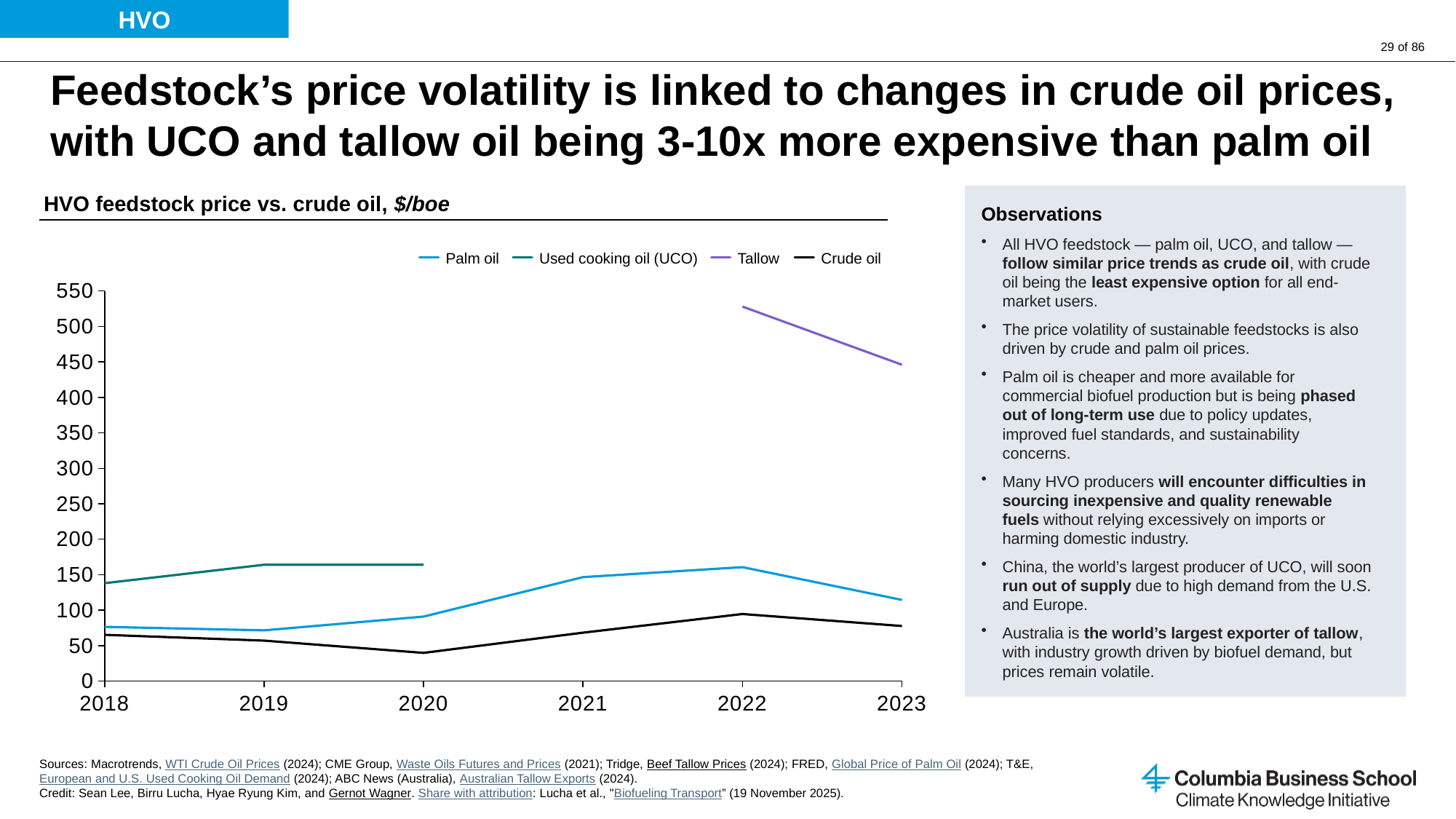
Which is larger in 2019, Used cooking oil (UCO) or Palm oil? Used cooking oil (UCO) Is the value for Tallow in 2022 greater or less than 500? greater How many years are shown on the x axis? 6 Which series has the lowest value in 2020? Crude oil Does the Crude oil line rise or fall from 2020 to 2022? rise What unit is given in the chart title? $/boe How many series does the legend list? 4 Does the Tallow line rise or fall from 2022 to 2023? fall Which series has the highest value in 2022? Tallow Is the value for Palm oil in 2022 greater or less than 150? greater Is the value for Crude oil in 2020 greater or less than 50? less What kind of chart is shown on the slide? line chart